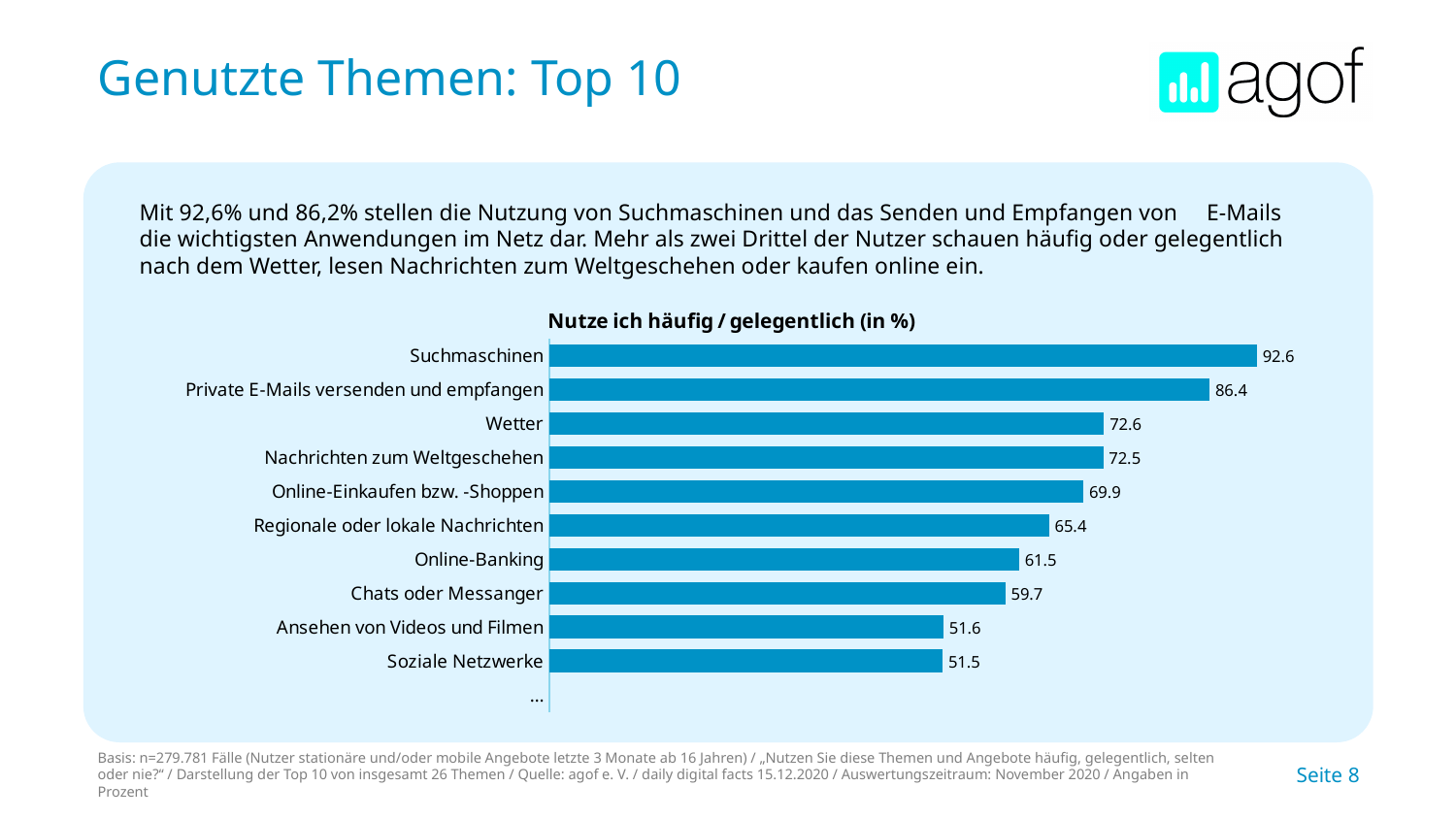
What is the difference between the values for Suchmaschinen and Private E-Mails versenden und empfangen? 6.2 What value is shown for Online-Banking? 61.5 What is the difference between the values for Wetter and Nachrichten zum Weltgeschehen? 0.1 What is the title of the chart? Nutze ich häufig / gelegentlich (in %) What value is shown for Chats oder Messanger? 59.7 What value is shown for Regionale oder lokale Nachrichten? 65.4 Which is larger, the value for Online-Einkaufen bzw. -Shoppen or the value for Online-Banking? Online-Einkaufen bzw. -Shoppen How many categories have a bar with a value shown in the chart? 10 Which category has the highest value? Suchmaschinen What kind of chart is shown on the slide? Bar chart What value is shown for Suchmaschinen? 92.6 Which category has the lowest value among the bars shown? Soziale Netzwerke